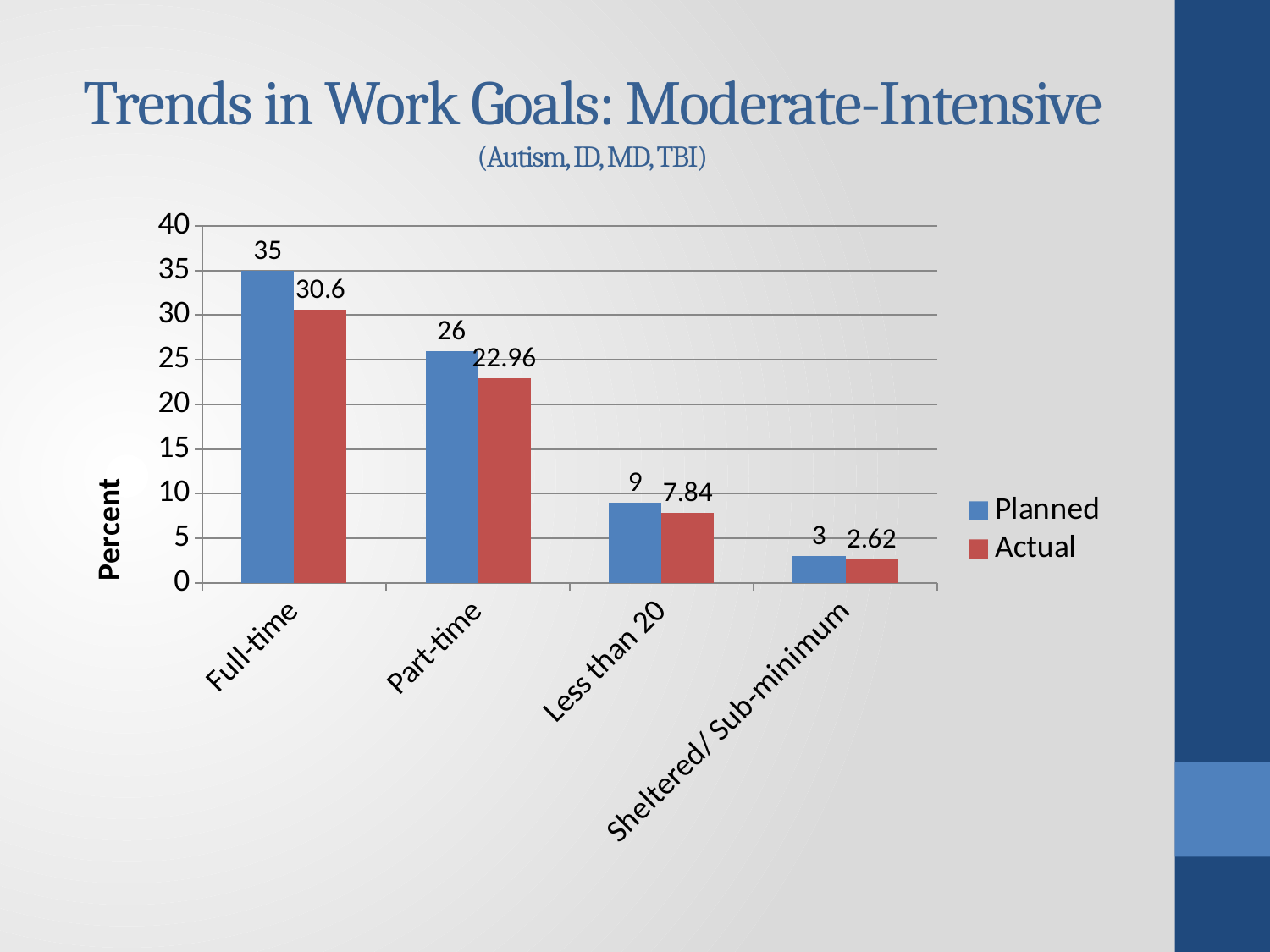
Which category has the highest Actual value? Full-time What is the difference between the Planned and Actual values for Full-time? 4.4 Which category has the lowest Planned value? Sheltered/ Sub-minimum Which is larger, the Planned value for Part-time or the Actual value for Full-time? Actual value for Full-time Do the Planned values rise or fall from Full-time to Sheltered/ Sub-minimum? Fall What is the Planned value for Full-time? 35 How many series does the legend list? 2 What is the Actual value for Sheltered/ Sub-minimum? 2.62 What kind of chart is shown on the slide? Bar chart What is the Actual value for Part-time? 22.96 How many categories are shown on the x axis? 4 What is the difference between the Planned and Actual values for Less than 20? 1.16